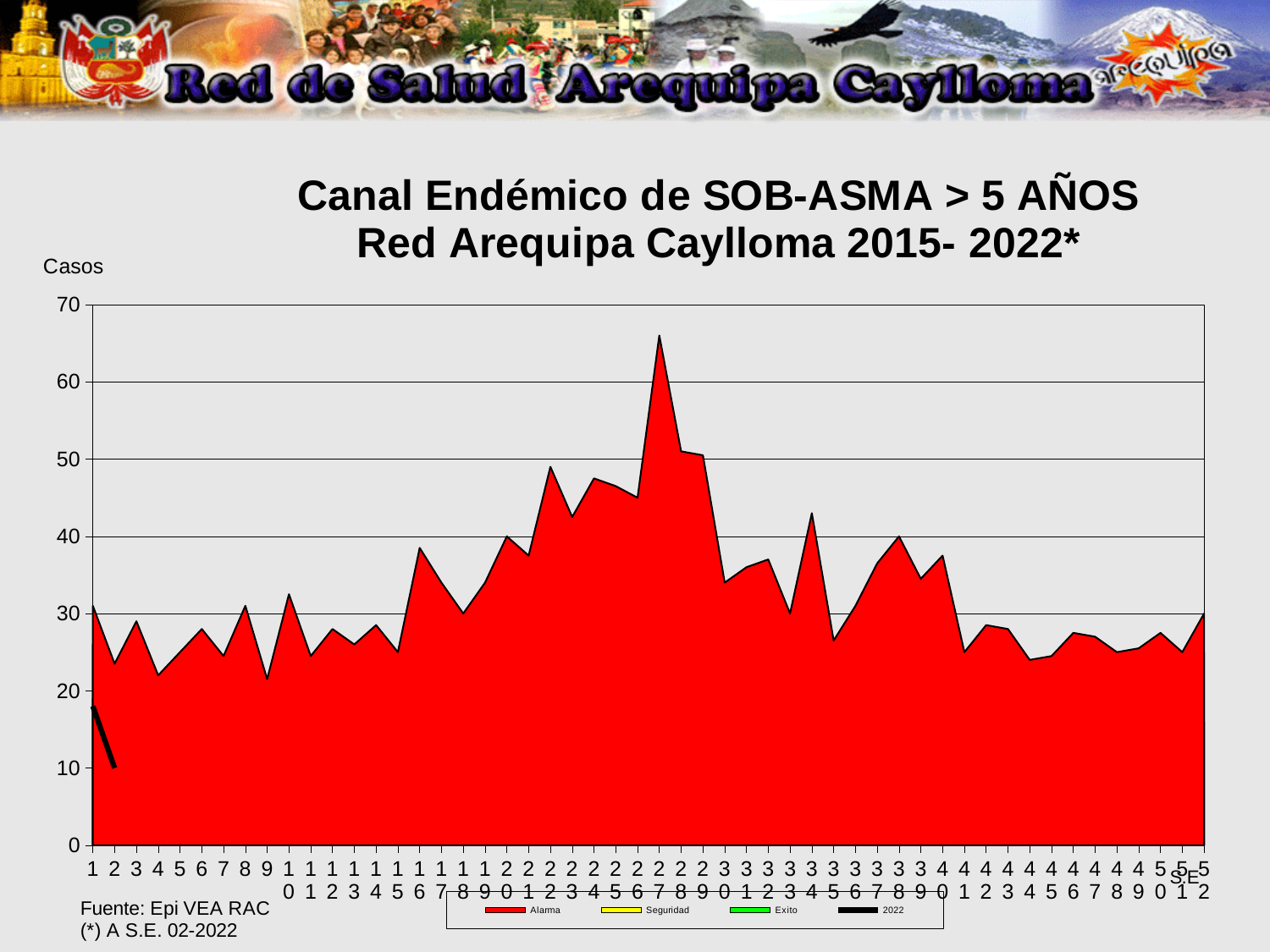
How many epidemiological weeks (S.E.) are shown on the x axis? 52 What kind of chart is shown on the slide? Combination area and line chart Is the Alarma value at week 16 greater or less than 30? greater What colour represents the 2022 series in the legend? Black At which week does the Alarma series reach its highest value? 27 What is the title of the chart? Canal Endémico de SOB-ASMA > 5 AÑOS Red Arequipa Caylloma 2015- 2022* Is the Alarma value at week 2 greater or less than 30? less Is the Alarma value at week 27 greater or less than 60? greater Which is larger, the Alarma value at week 27 or at week 1? Week 27 How many series does the legend list? 4 Do the Alarma values rise or fall from week 27 to week 30? Fall